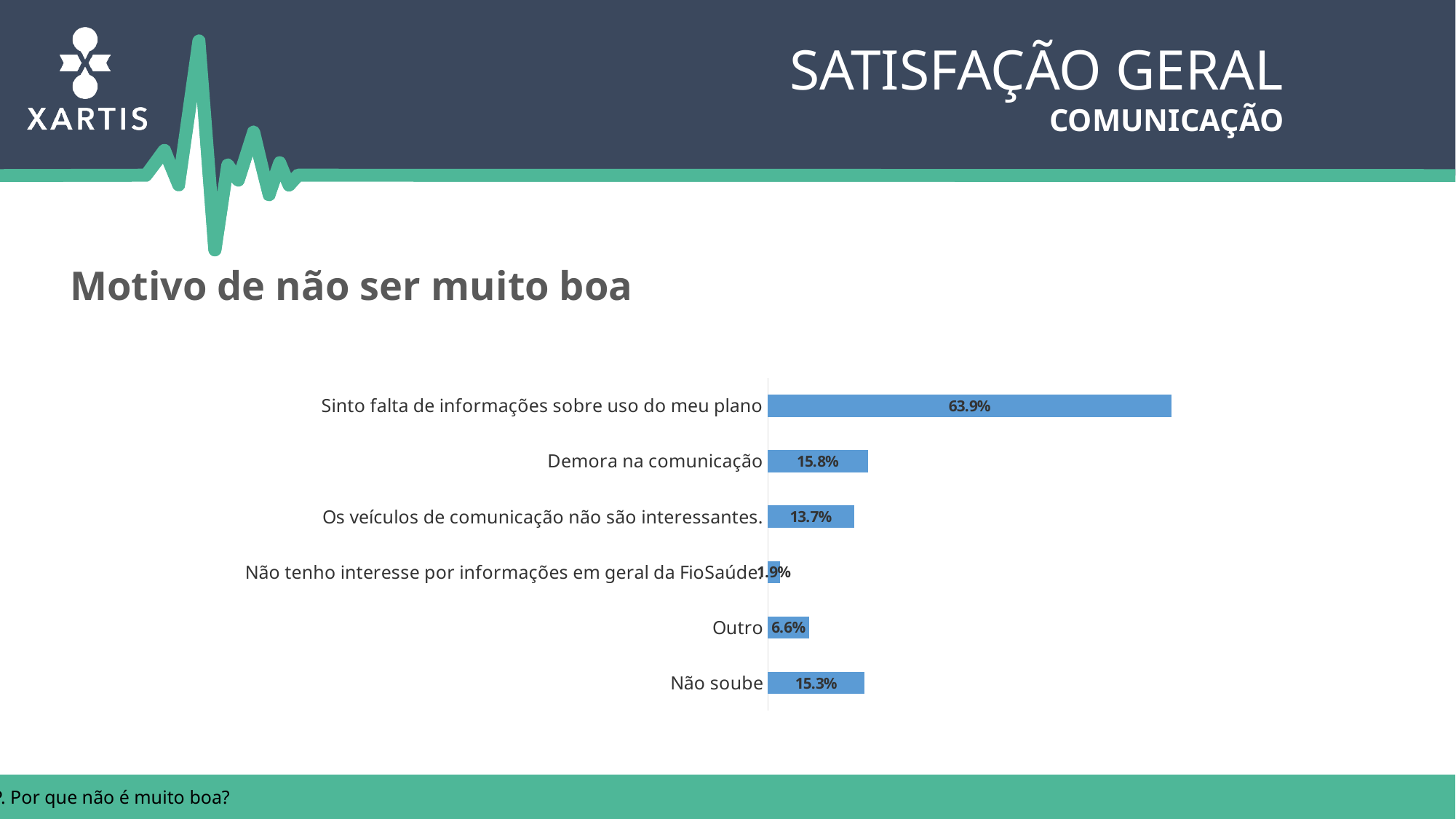
What is the value for 'Demora na comunicação'? 15.8% Which is larger, 'Demora na comunicação' or 'Não soube'? Demora na comunicação What is the value for 'Sinto falta de informações sobre uso do meu plano'? 63.9% What is the value for 'Não soube'? 15.3% How many categories are shown in the chart? 6 What is the difference between 'Sinto falta de informações sobre uso do meu plano' and 'Demora na comunicação'? 48.1% Which category has the lowest value? Não tenho interesse por informações em geral da FioSaúde What is the title of the chart? Motivo de não ser muito boa Which category has the highest value? Sinto falta de informações sobre uso do meu plano What is the value for 'Os veículos de comunicação não são interessantes.'? 13.7% What kind of chart is shown on the slide? Bar chart What is the value for 'Outro'? 6.6%